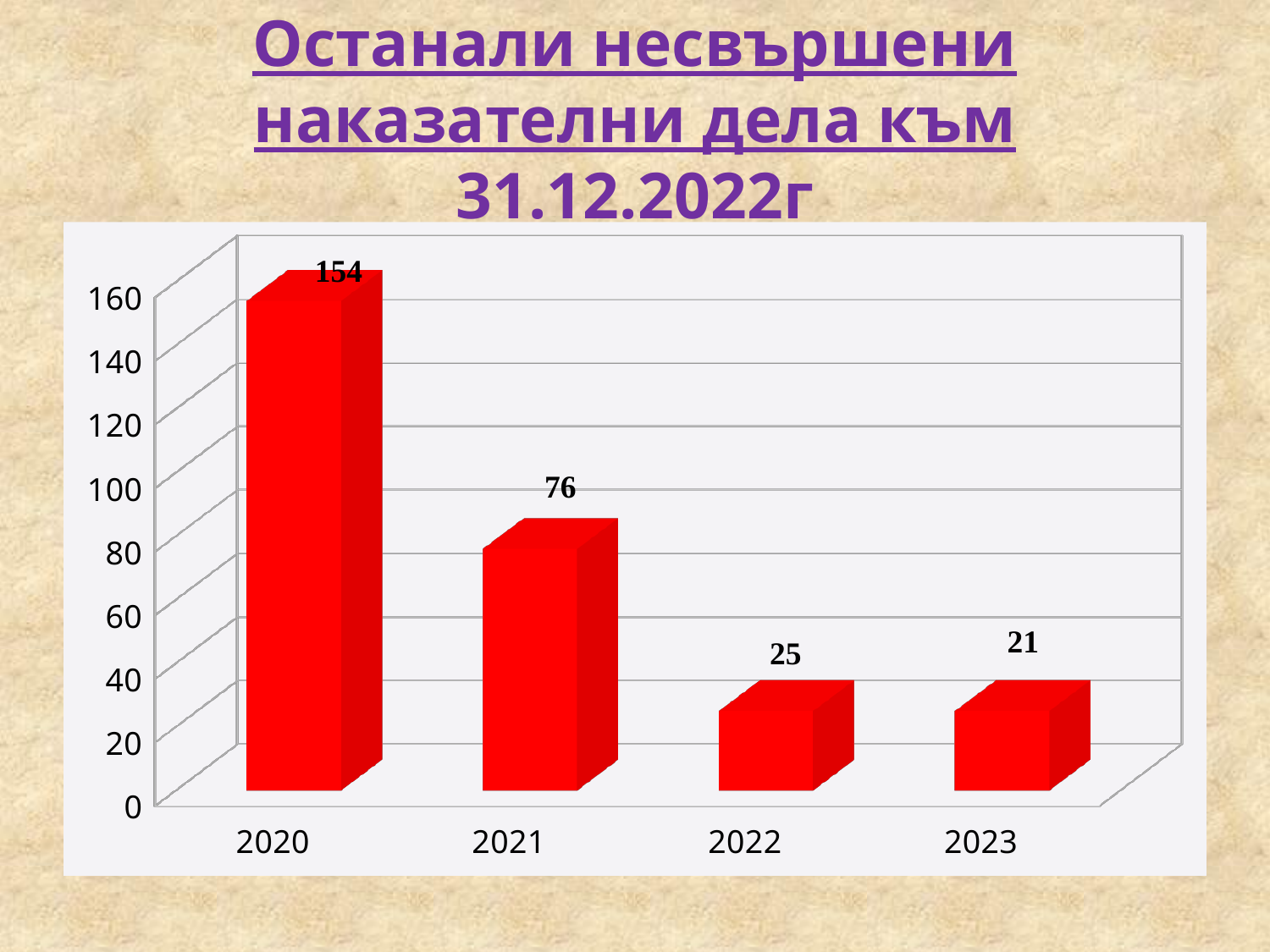
What is the value for 2021? 76 What is the difference between the values for 2020 and 2021? 78 What is the difference between the values for 2022 and 2023? 4 Do the values rise or fall from 2020 to 2023? fall Which is larger, the value for 2021 or the value for 2022? 2021 What is the value for 2023? 21 Which year has the lowest value? 2023 What is the value for 2022? 25 How many years are shown on the x axis? 4 Which year has the highest value? 2020 What kind of chart is shown on the slide? bar chart What is the value for 2020? 154